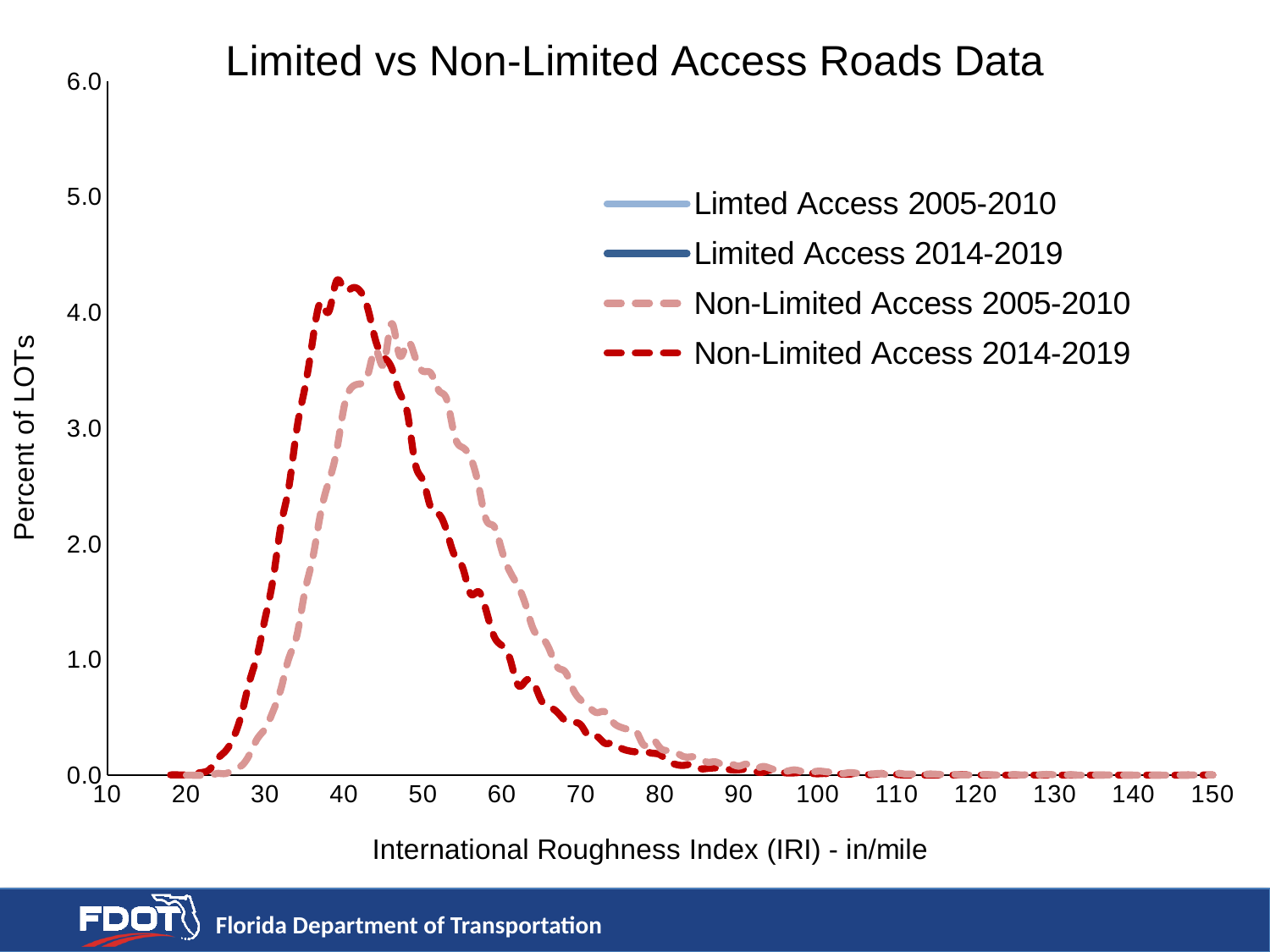
What is the label of the vertical axis? Percent of LOTs Is the value for Non-Limited Access 2014-2019 at an IRI of 60 greater or less than 2.0? less Is the value for Non-Limited Access 2005-2010 at an IRI of 40 greater or less than 4.0? less Does the Non-Limited Access 2014-2019 series rise or fall as IRI increases from 50 to 150? fall At an IRI of 40, which series has the higher value: Non-Limited Access 2005-2010 or Non-Limited Access 2014-2019? Non-Limited Access 2014-2019 What kind of chart is shown on the slide? line chart Is the value for Non-Limited Access 2005-2010 at an IRI of 70 greater or less than 1.0? less What is the title of the chart? Limited vs Non-Limited Access Roads Data How many series does the legend list? 4 At an IRI of 50, which series has the higher value: Non-Limited Access 2005-2010 or Non-Limited Access 2014-2019? Non-Limited Access 2005-2010 Which of the two Non-Limited Access series reaches the higher peak value? Non-Limited Access 2014-2019